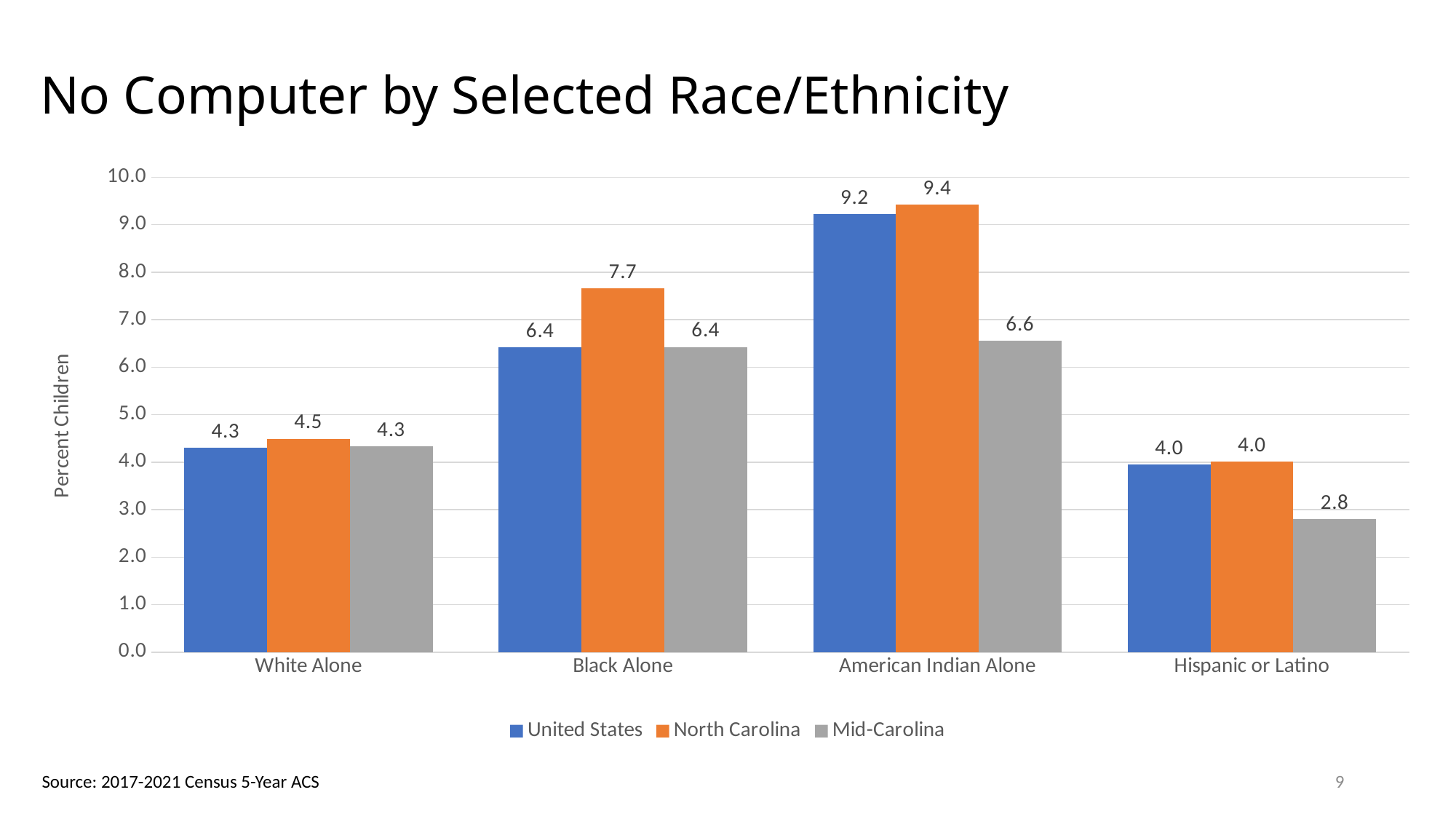
What is the difference between the North Carolina and Mid-Carolina values for American Indian Alone? 2.8 Is the United States value for Black Alone greater or less than 5.0? greater Which race/ethnicity category has the highest North Carolina value? American Indian Alone How many series does the legend list? 3 Which is larger for Black Alone: the North Carolina value or the Mid-Carolina value? North Carolina What is the Mid-Carolina value for Hispanic or Latino? 2.8 Which race/ethnicity category has the lowest Mid-Carolina value? Hispanic or Latino What kind of chart is shown on the slide? Bar chart What is the United States value for American Indian Alone? 9.2 What is the North Carolina value for Black Alone? 7.7 How many race/ethnicity categories are shown on the x axis? 4 What is the label of the vertical axis? Percent Children